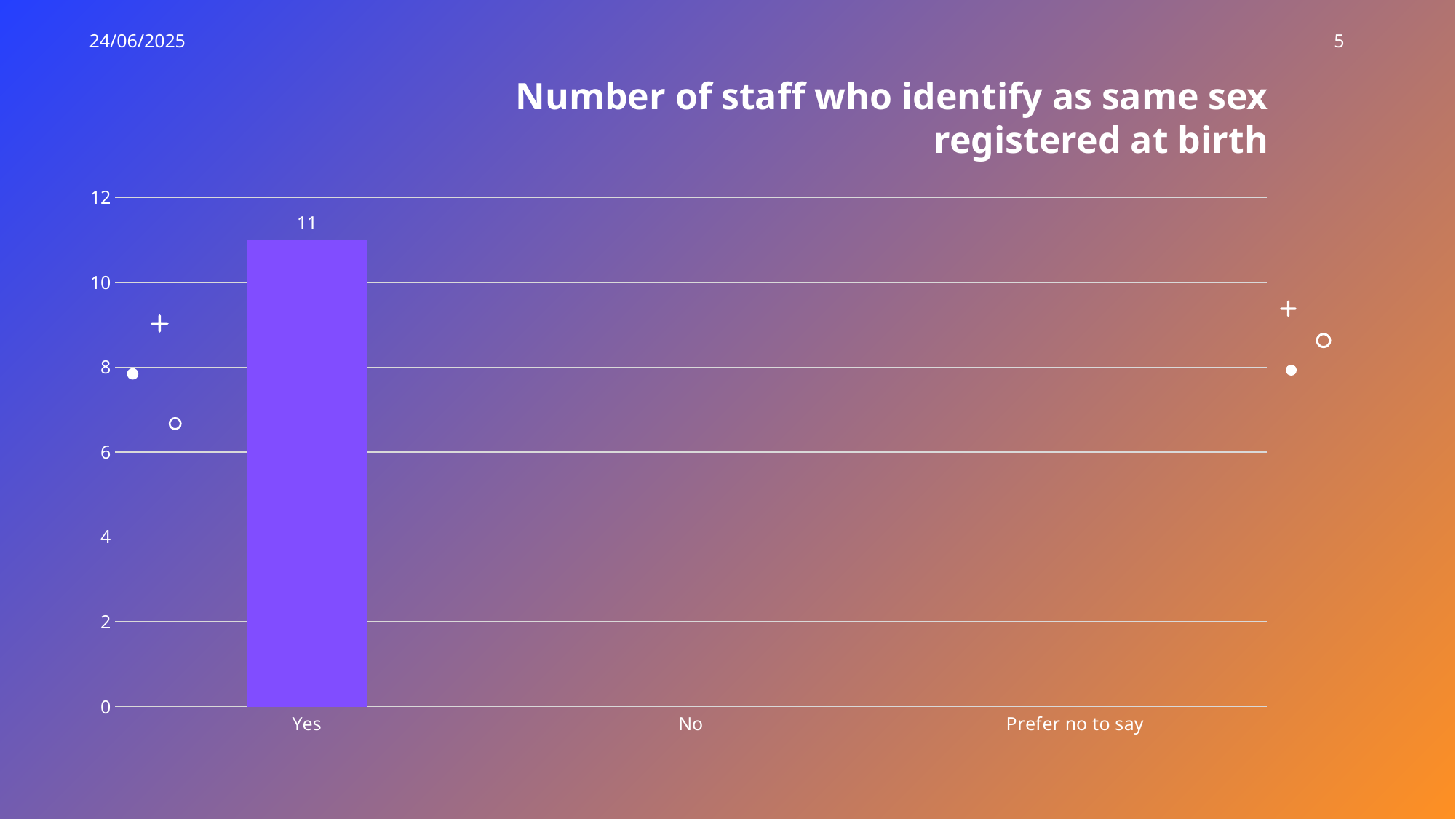
What is the highest value shown on the y axis? 12 What is the label of the third category on the x axis? Prefer no to say What is the title of the chart? Number of staff who identify as same sex registered at birth What is the value for Yes? 11 Which is larger, the value for Yes or the value for No? Yes Is the value for Yes greater or less than 12? less What kind of chart is shown on the slide? Bar chart How many categories are shown on the x axis? 3 Is the value for Yes greater or less than 10? greater Which category has the highest value? Yes